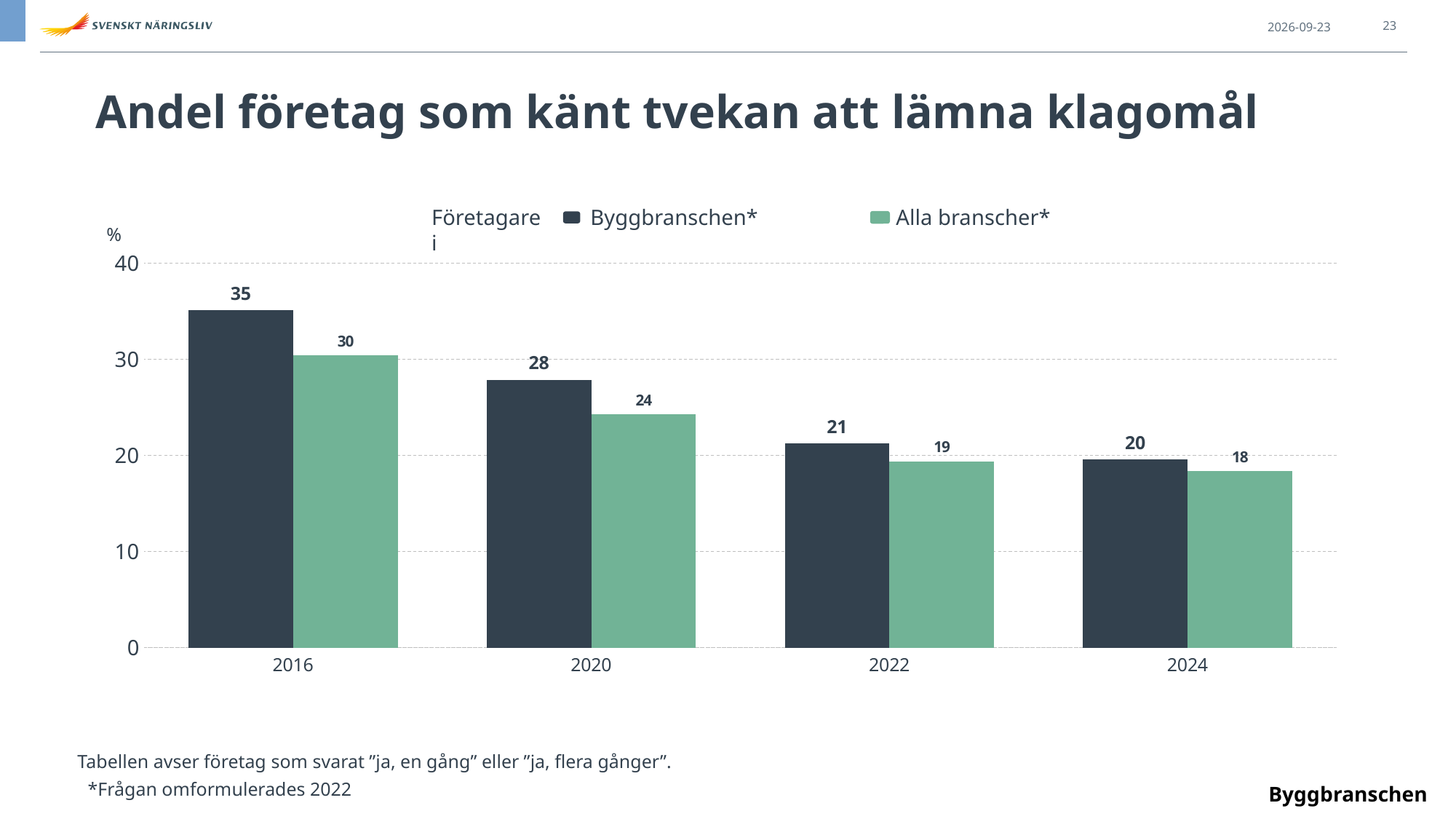
Do the values for Byggbranschen* rise or fall from 2016 to 2024? fall How many years are shown on the x axis? 4 Is the value for Byggbranschen* in 2020 greater or less than 30? less What kind of chart is shown? bar chart What is the value for Byggbranschen* in 2024? 20 In which year is the value for Byggbranschen* lowest? 2024 Which is larger in 2022, Byggbranschen* or Alla branscher*? Byggbranschen* In which year is the value for Alla branscher* highest? 2016 What is the value for Alla branscher* in 2020? 24 How many series does the legend list? 2 What is the difference between Byggbranschen* and Alla branscher* in 2016? 5 What is the value for Byggbranschen* in 2016? 35